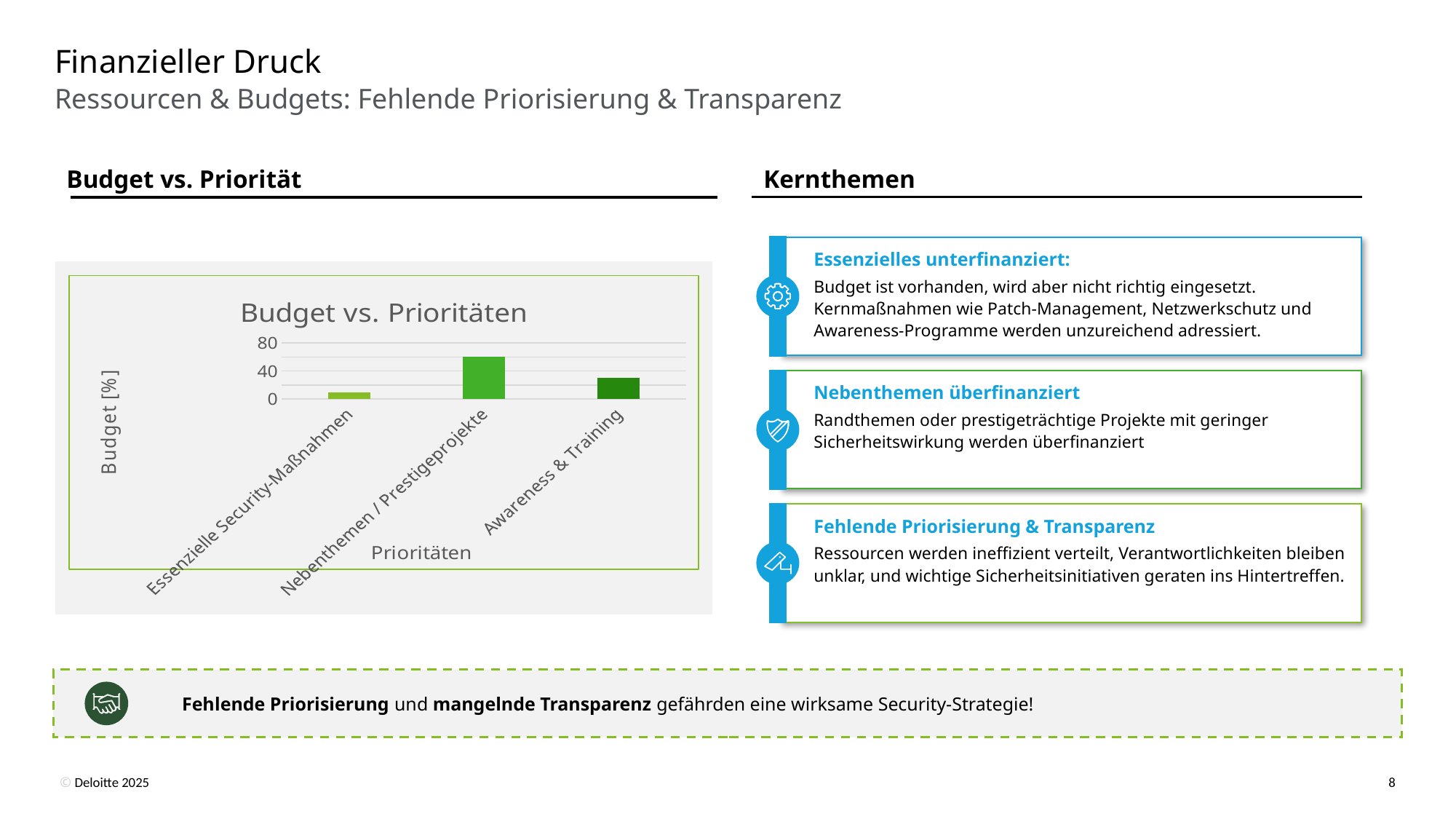
What type of chart is shown on the slide? bar chart Is the value for Awareness & Training greater or less than 40? less Is the value for Nebenthemen / Prestigeprojekte greater or less than 80? less Which has a larger budget share: Nebenthemen / Prestigeprojekte or Awareness & Training? Nebenthemen / Prestigeprojekte What is the label of the vertical axis of the chart? Budget [%] Which category has the lowest budget share in the chart? Essenzielle Security-Maßnahmen Which has a larger budget share: Awareness & Training or Essenzielle Security-Maßnahmen? Awareness & Training Is the value for Essenzielle Security-Maßnahmen greater or less than 40? less Which category has the highest budget share in the chart? Nebenthemen / Prestigeprojekte What is the title of the chart? Budget vs. Prioritäten How many categories are shown on the x axis of the chart? 3